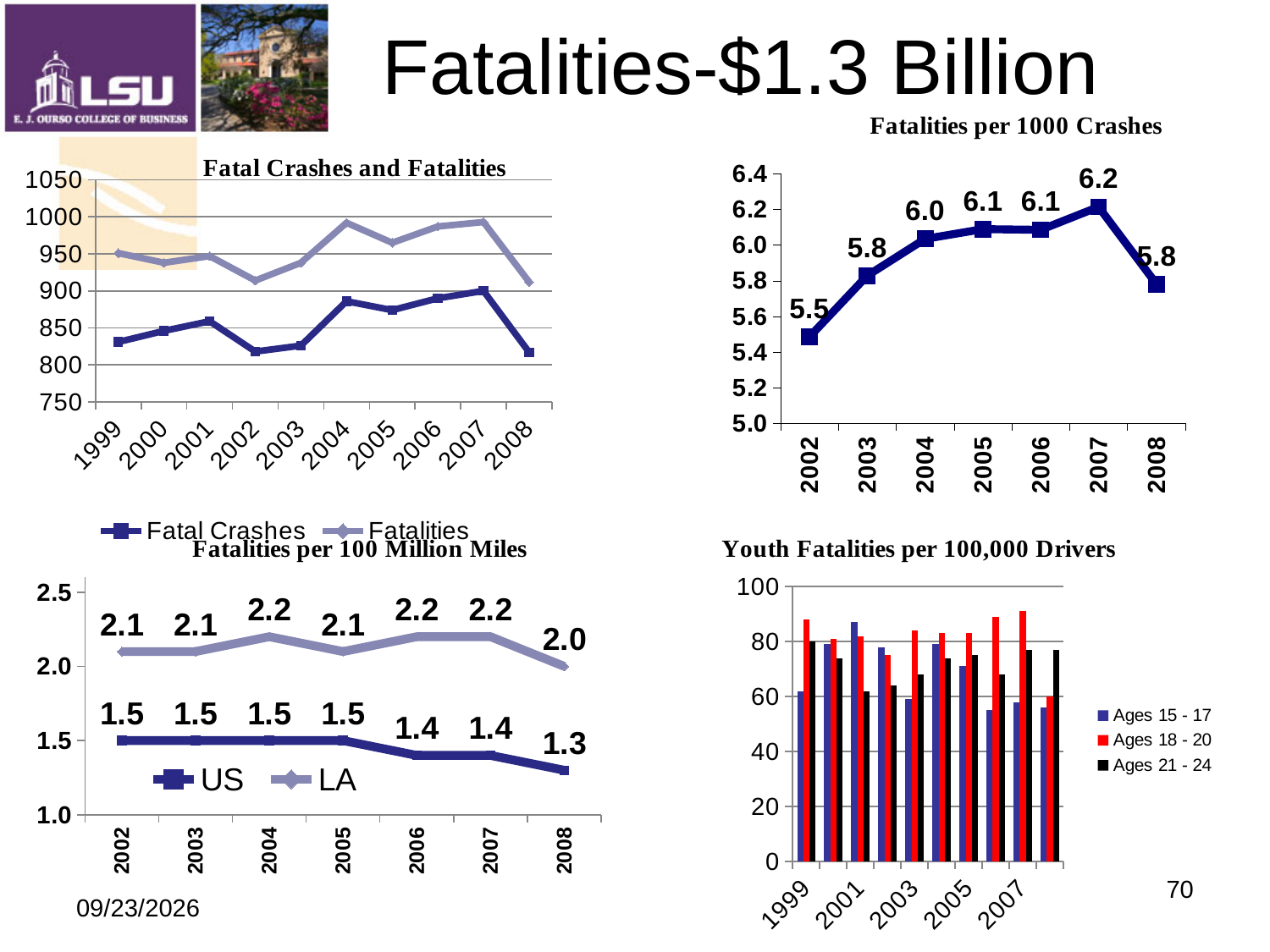
How many series does the legend of the 'Fatalities per 100 Million Miles' chart list? 2 In the 'Fatalities per 1000 Crashes' chart, what is the value for 2007? 6.2 In the 'Fatalities per 1000 Crashes' chart, which year has the lowest value? 2002 In the 'Fatal Crashes and Fatalities' chart, is the Fatal Crashes value for 2002 greater or less than 850? less How many series does the legend of the 'Youth Fatalities per 100,000 Drivers' chart list? 3 What kind of chart is 'Youth Fatalities per 100,000 Drivers'? bar chart In the 'Fatalities per 100 Million Miles' chart, what is the difference between the LA and US values in 2004? 0.7 In the 'Fatalities per 100 Million Miles' chart, what is the LA value for 2008? 2.0 In the 'Fatalities per 100 Million Miles' chart, what is the US value for 2008? 1.3 What kind of chart is 'Fatal Crashes and Fatalities'? line chart In the 'Fatalities per 100 Million Miles' chart, does the US series rise or fall from 2002 to 2008? fall In the 'Fatalities per 1000 Crashes' chart, what is the difference between the 2007 value and the 2002 value? 0.7